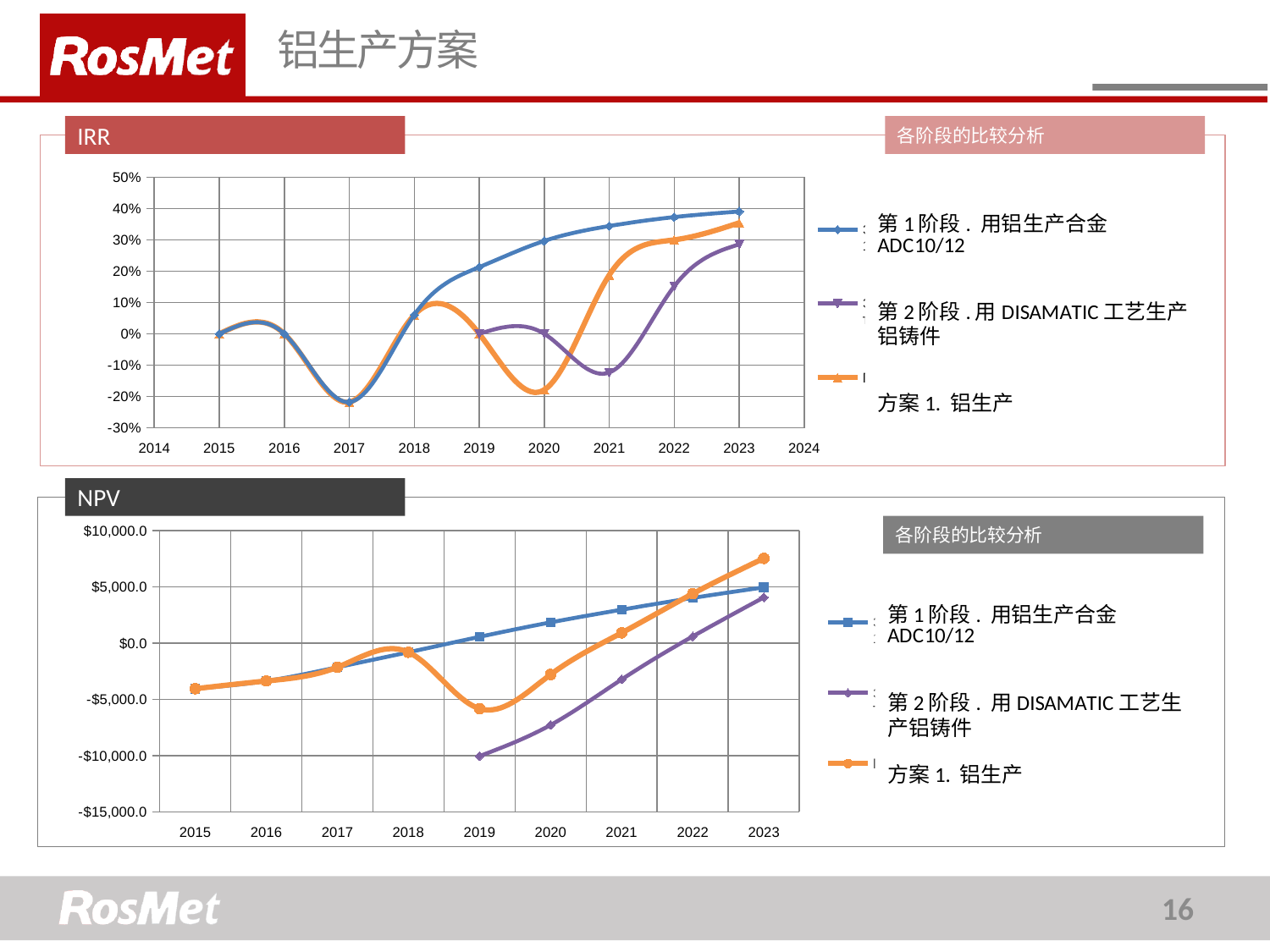
How many year labels are shown on the x axis of the NPV chart? 9 How many series does the legend of the NPV chart list? 3 In the IRR chart, which series has the higher value in 2023: 第1阶段 (ADC10/12) or 第2阶段 (DISAMATIC)? 第1阶段 (ADC10/12) In the NPV chart, does the 第2阶段 (DISAMATIC) series rise or fall from 2019 to 2023? rise What kind of chart is the IRR chart at the top of the slide? Line chart In the NPV chart, which series has the higher value in 2023: 方案1 or 第1阶段 (ADC10/12)? 方案1 In the NPV chart, is the value for 第2阶段 (DISAMATIC) in 2019 greater or less than -$5,000.0? less In the IRR chart, is the value for 第1阶段 (ADC10/12) in 2023 greater or less than 30%? greater In the NPV chart, is the value for 方案1 in 2023 greater or less than $5,000.0? greater